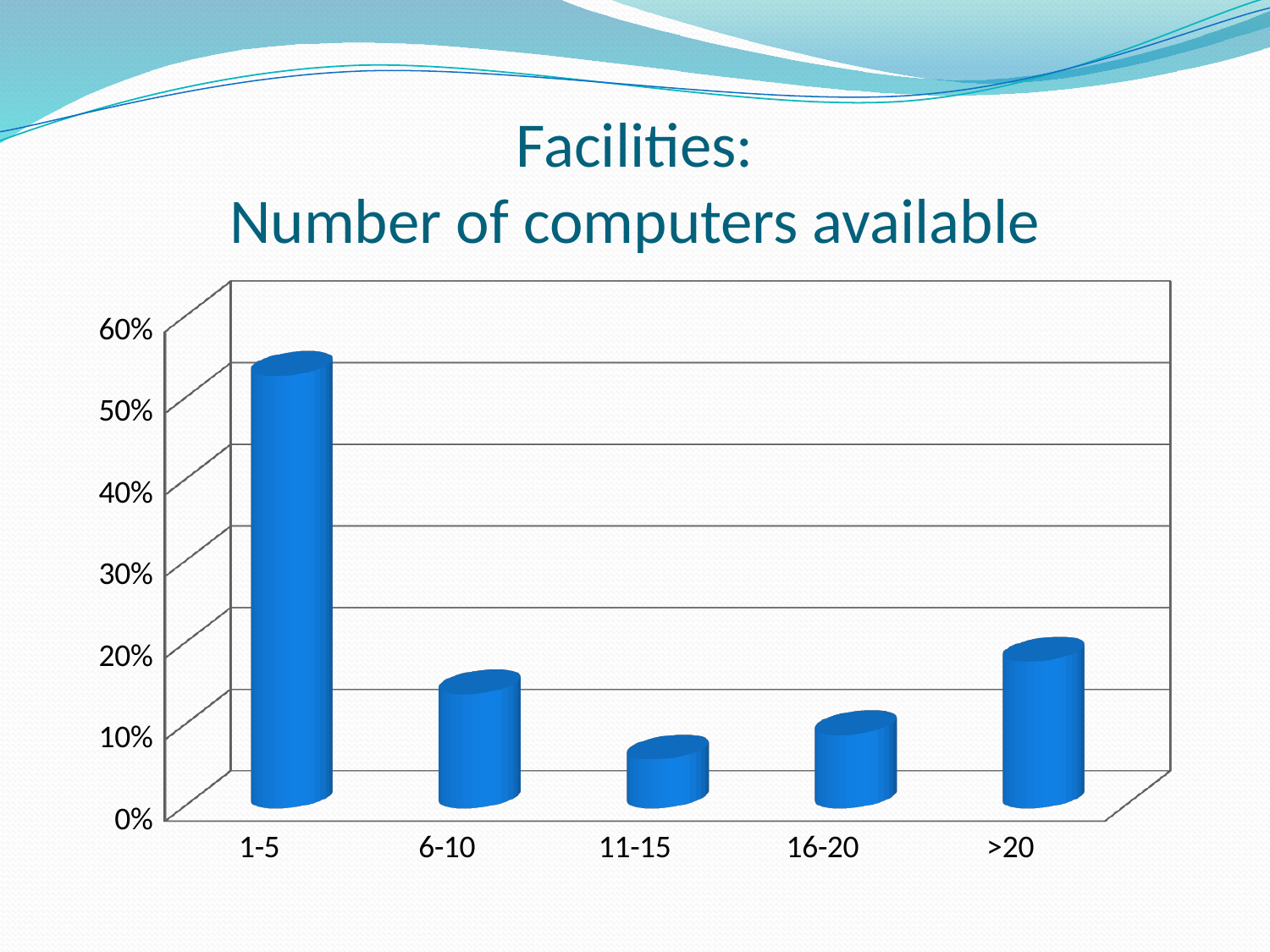
Is the value for 6-10 greater or less than 10%? greater Which is larger, the value for >20 or the value for 11-15? >20 Is the value for >20 greater or less than 30%? less Is the value for 1-5 greater or less than 50%? greater How many categories are shown on the x axis of the chart? 5 What kind of chart is shown on the slide? bar chart Which category has the highest value in the chart? 1-5 Which category has the lowest value in the chart? 11-15 Which is larger, the value for 6-10 or the value for 16-20? 6-10 What is the title of the chart on the slide? Facilities: Number of computers available